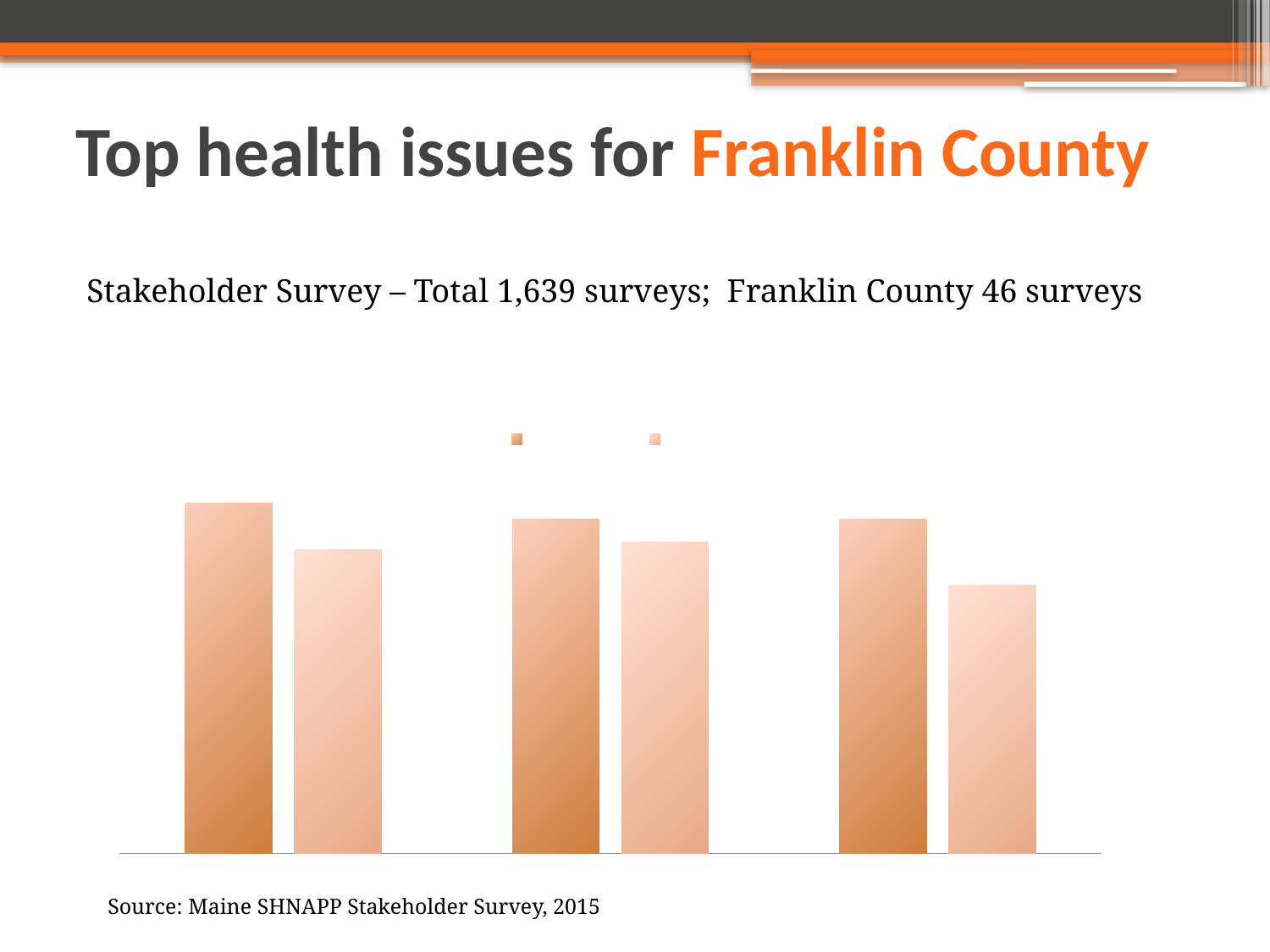
How many groups of bars are plotted in the chart? 3 Does the chart display any numeric data labels on its bars? No Which group of bars contains the tallest bar in the chart: the leftmost, middle, or rightmost? leftmost What kind of chart is shown on the slide? bar chart In the leftmost group of bars, is the darker orange bar or the lighter orange bar taller? the darker orange bar In the rightmost group of bars, is the darker orange bar or the lighter orange bar taller? the darker orange bar Which group of bars contains the shortest bar in the chart: the leftmost, middle, or rightmost? rightmost How many series does the chart's legend list? 2